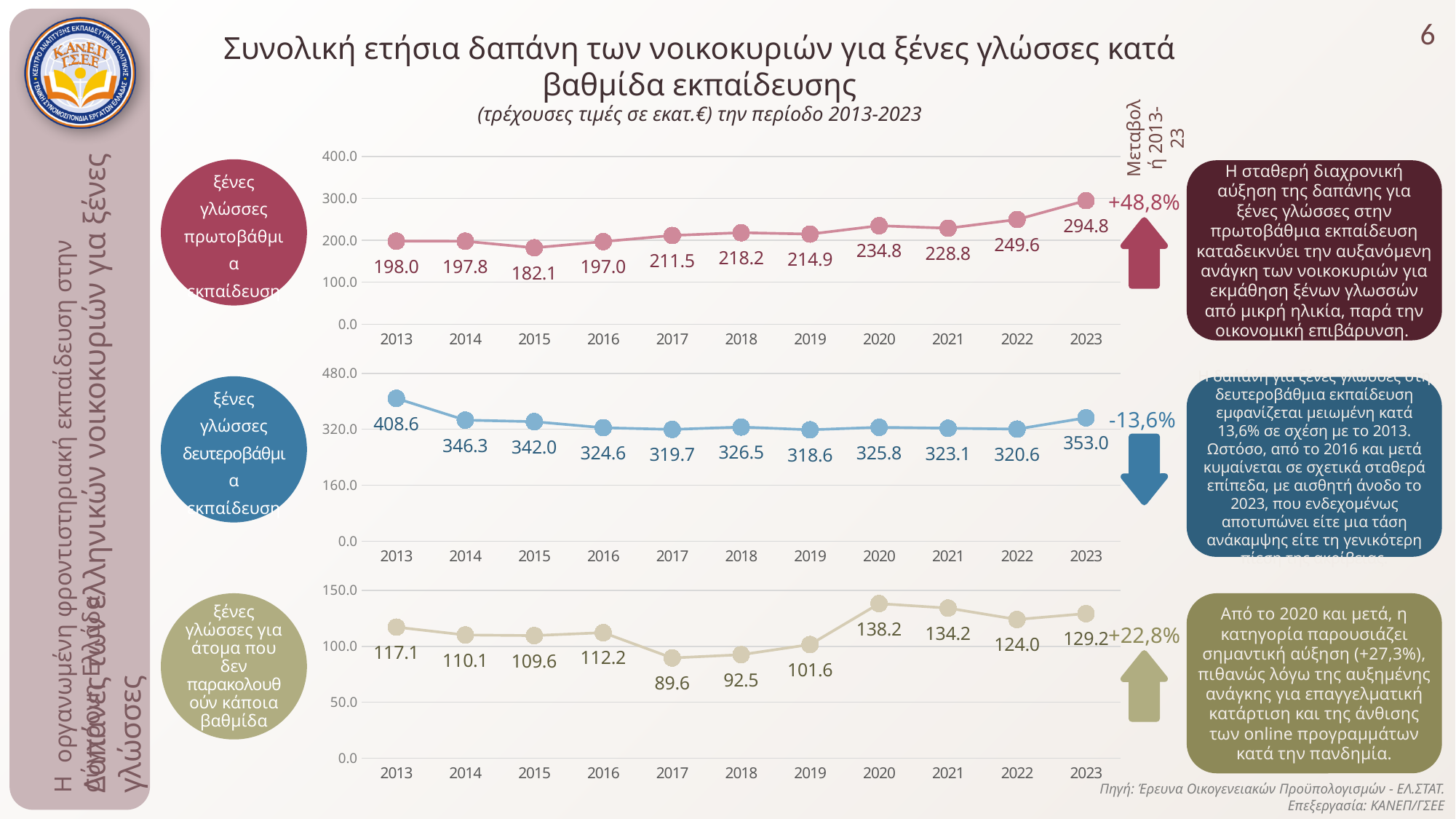
What percentage change for 2013-23 is shown next to the middle chart? -13,6% In the bottom chart (ξένες γλώσσες για άτομα που δεν παρακολουθούν κάποια βαθμίδα), what is the value for 2017? 89.6 In the bottom chart, which is larger, the value for 2020 or the value for 2021? 2020 In the top chart, which year has the highest value? 2023 In the top chart, which year has the lowest value? 2015 In the top chart (ξένες γλώσσες πρωτοβάθμια εκπαίδευση), what is the value for 2020? 234.8 In the bottom chart, what is the difference between the 2020 value and the 2019 value? 36.6 In the top chart, what is the difference between the 2023 value and the 2013 value? 96.8 What kind of chart is the middle chart? line chart In the middle chart (ξένες γλώσσες δευτεροβάθμια εκπαίδευση), what is the value for 2023? 353.0 How many years are plotted in the top chart? 11 In the middle chart, which year has the highest value? 2013